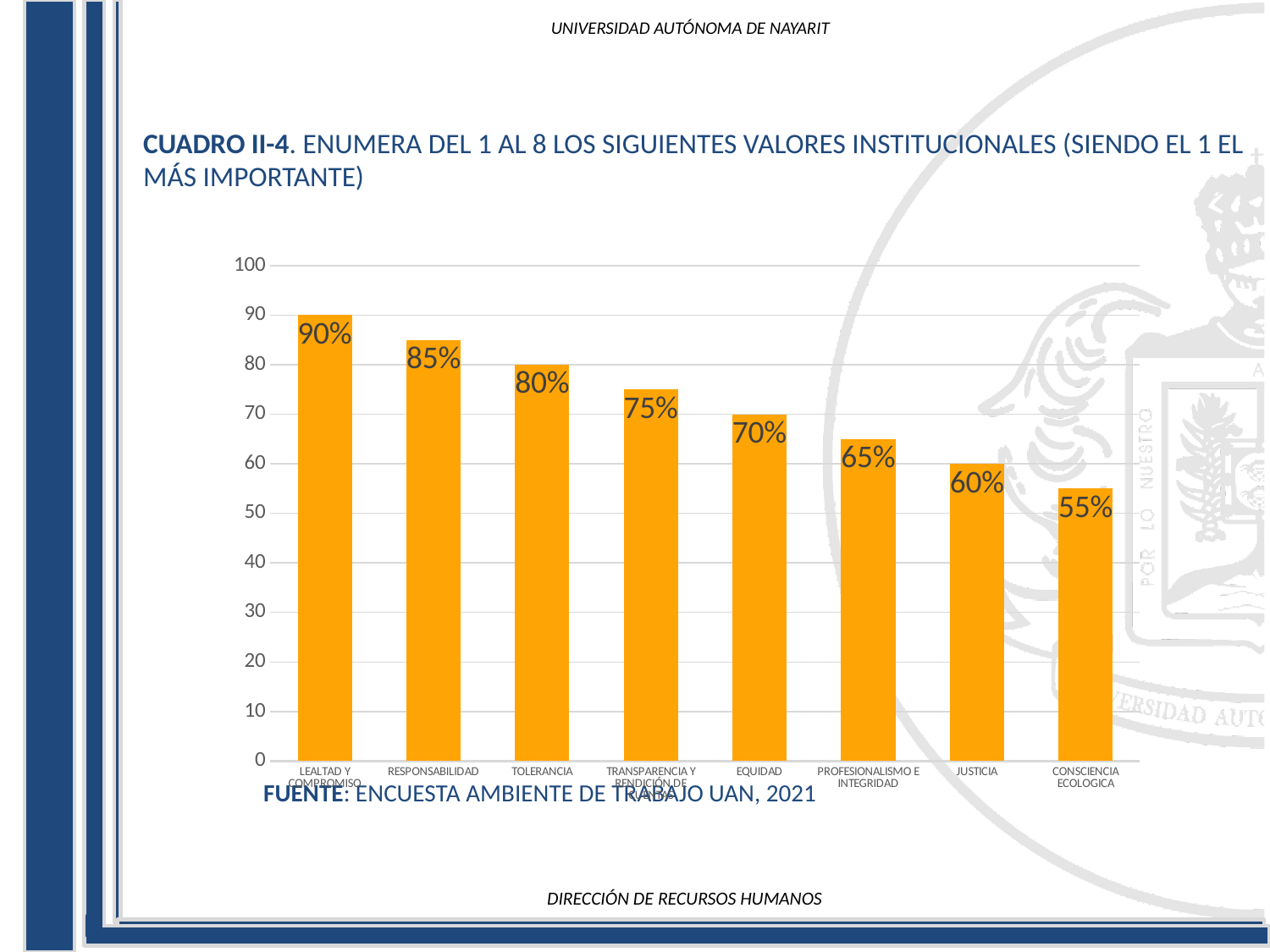
Which category has the lowest value? CONSCIENCIA ECOLOGICA What kind of chart is shown on the slide? bar chart Do the values rise or fall from left to right along the x axis? fall Is the value for CONSCIENCIA ECOLOGICA greater or less than 60? less What is the difference between the values for RESPONSABILIDAD and PROFESIONALISMO E INTEGRIDAD? 20% How many categories are shown in the chart? 8 What colour are the bars in the chart? orange What is the value for EQUIDAD? 70% Which category has the highest value? LEALTAD Y COMPROMISO What is the value for TOLERANCIA? 80% What is the value for JUSTICIA? 60% Which is larger, the value for TOLERANCIA or the value for JUSTICIA? TOLERANCIA